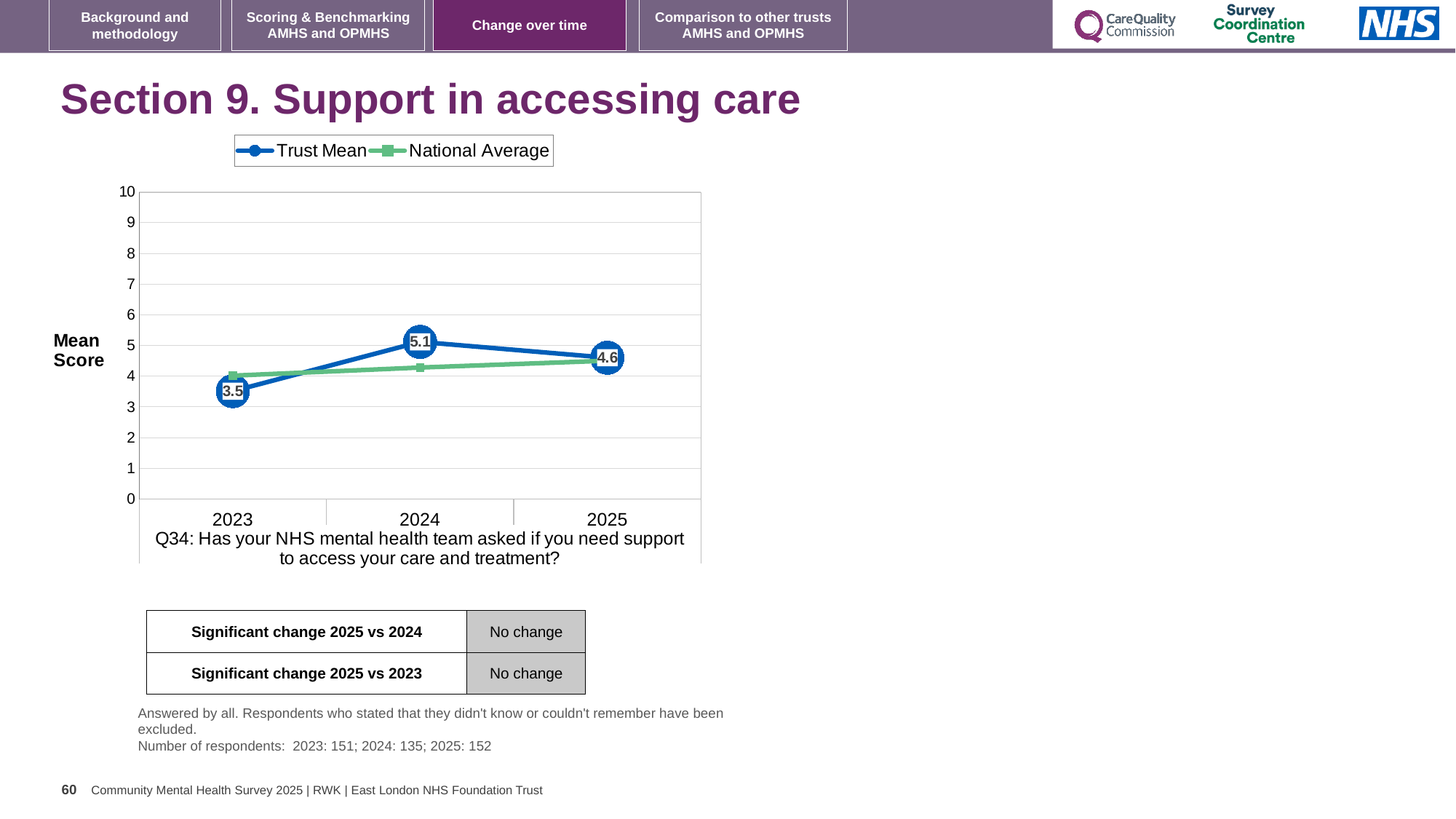
Is the National Average value for 2023 greater or less than 5? less Did the Trust Mean rise or fall from 2024 to 2025? fall What is the Trust Mean score for 2023? 3.5 Which is larger in 2023: the Trust Mean or the National Average? National Average How many years are plotted on the x axis? 3 What is the Trust Mean score for 2024? 5.1 In which year is the Trust Mean lowest? 2023 What is the Trust Mean score for 2025? 4.6 In which year is the Trust Mean highest? 2024 How many series does the legend list? 2 What kind of chart is shown on the slide? line chart What is the difference between the Trust Mean in 2024 and in 2023? 1.6